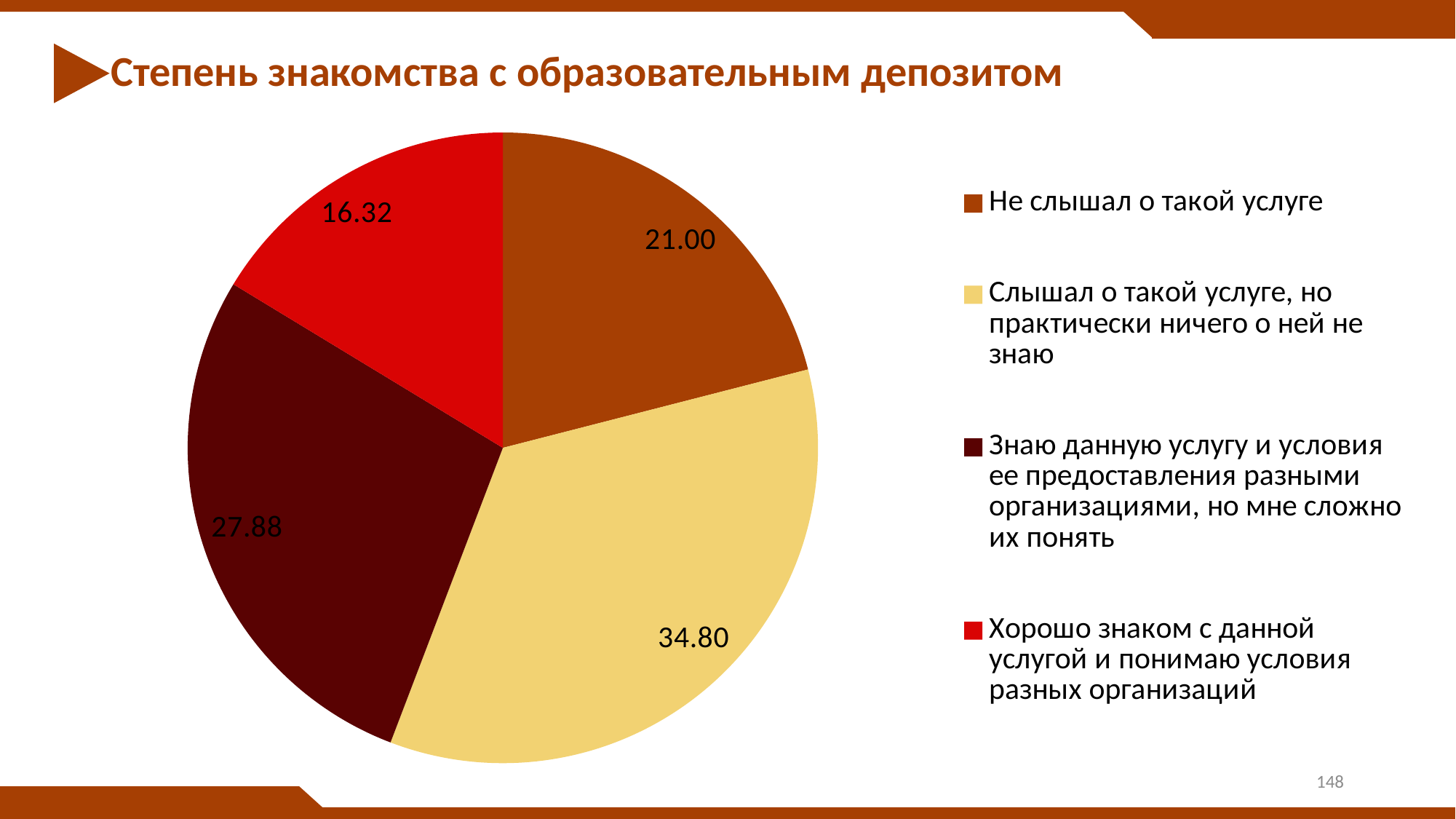
Which category has the smallest slice of the pie? Хорошо знаком с данной услугой и понимаю условия разных организаций What kind of chart is shown on the slide? pie chart What is the difference between the values for "Слышал о такой услуге, но практически ничего о ней не знаю" and "Не слышал о такой услуге"? 13.80 What is the title of the slide? Степень знакомства с образовательным депозитом What colour is the slice for "Не слышал о такой услуге"? brown What is the value for "Знаю данную услугу и условия ее предоставления разными организациями, но мне сложно их понять"? 27.88 How many slices does the pie chart have? 4 What is the value for "Хорошо знаком с данной услугой и понимаю условия разных организаций"? 16.32 Which category has the largest slice of the pie? Слышал о такой услуге, но практически ничего о ней не знаю What is the value for "Слышал о такой услуге, но практически ничего о ней не знаю"? 34.80 What is the value for "Не слышал о такой услуге"? 21.00 Which is larger: the value for "Не слышал о такой услуге" or the value for "Хорошо знаком с данной услугой и понимаю условия разных организаций"? Не слышал о такой услуге